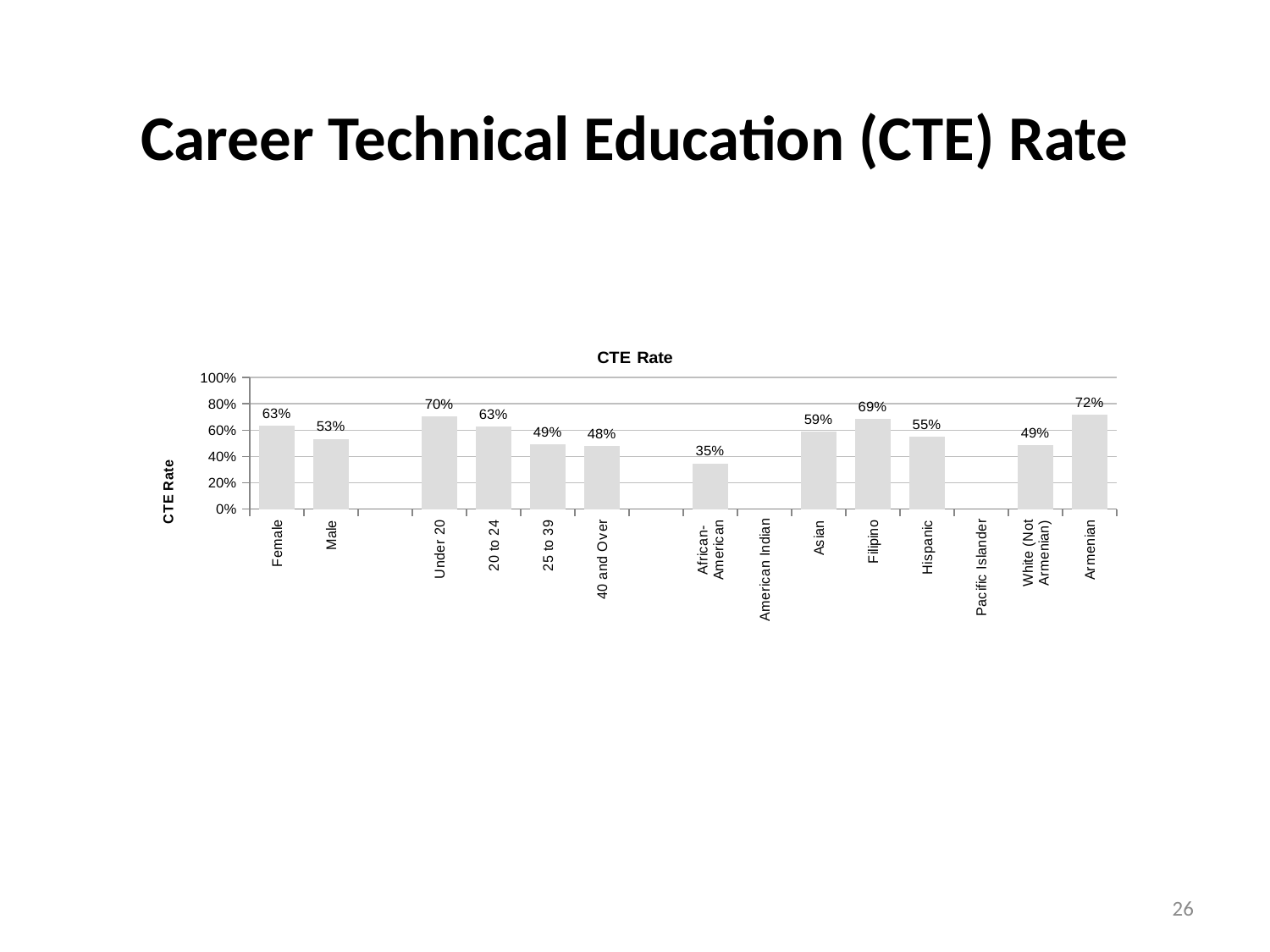
What is the CTE rate for African-American? 35% Which has a higher CTE rate, Filipino or Asian? Filipino What is the CTE rate for Female? 63% Which category with a plotted bar has the lowest CTE rate? African-American What is the CTE rate for Hispanic? 55% What is the difference between the CTE rate for Under 20 and for 40 and Over? 22 percentage points Is the CTE rate for Male greater or less than 60%? less How many category labels are shown on the x axis? 14 Which category has the highest CTE rate? Armenian What is the title of the chart? CTE Rate What kind of chart is shown on the slide? bar chart What is the CTE rate for Under 20? 70%